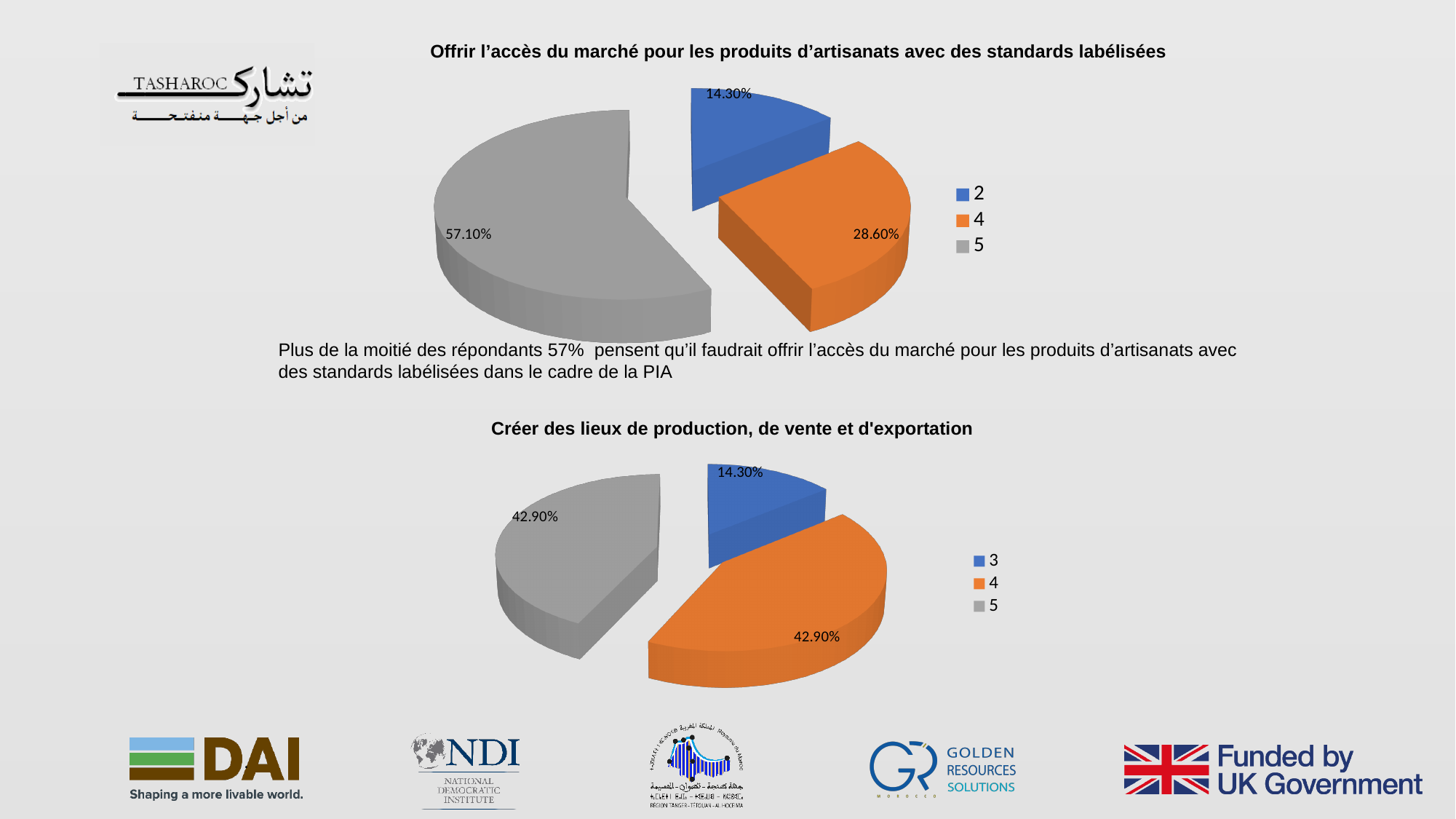
In the top chart titled "Offrir l'accès du marché pour les produits d'artisanats avec des standards labélisées", which category has the largest share? 5 What kind of chart is the bottom chart titled "Créer des lieux de production, de vente et d'exportation"? Pie chart In the top chart titled "Offrir l'accès du marché pour les produits d'artisanats avec des standards labélisées", how many categories does the legend list? 3 In the bottom chart titled "Créer des lieux de production, de vente et d'exportation", which colour represents category 5 in the legend? Grey In the bottom chart titled "Créer des lieux de production, de vente et d'exportation", what is the value for category 3? 14.30% In the bottom chart titled "Créer des lieux de production, de vente et d'exportation", what is the difference between the values for category 4 and category 3? 28.60% In the top chart titled "Offrir l'accès du marché pour les produits d'artisanats avec des standards labélisées", which category has the smallest share? 2 In the bottom chart titled "Créer des lieux de production, de vente et d'exportation", which category has the smallest share? 3 In the bottom chart titled "Créer des lieux de production, de vente et d'exportation", what is the value for category 4? 42.90% In the top chart titled "Offrir l'accès du marché pour les produits d'artisanats avec des standards labélisées", what is the difference between the values for category 5 and category 4? 28.50% In the top chart titled "Offrir l'accès du marché pour les produits d'artisanats avec des standards labélisées", what is the value for category 5? 57.10% In the top chart titled "Offrir l'accès du marché pour les produits d'artisanats avec des standards labélisées", what is the value for category 4? 28.60%